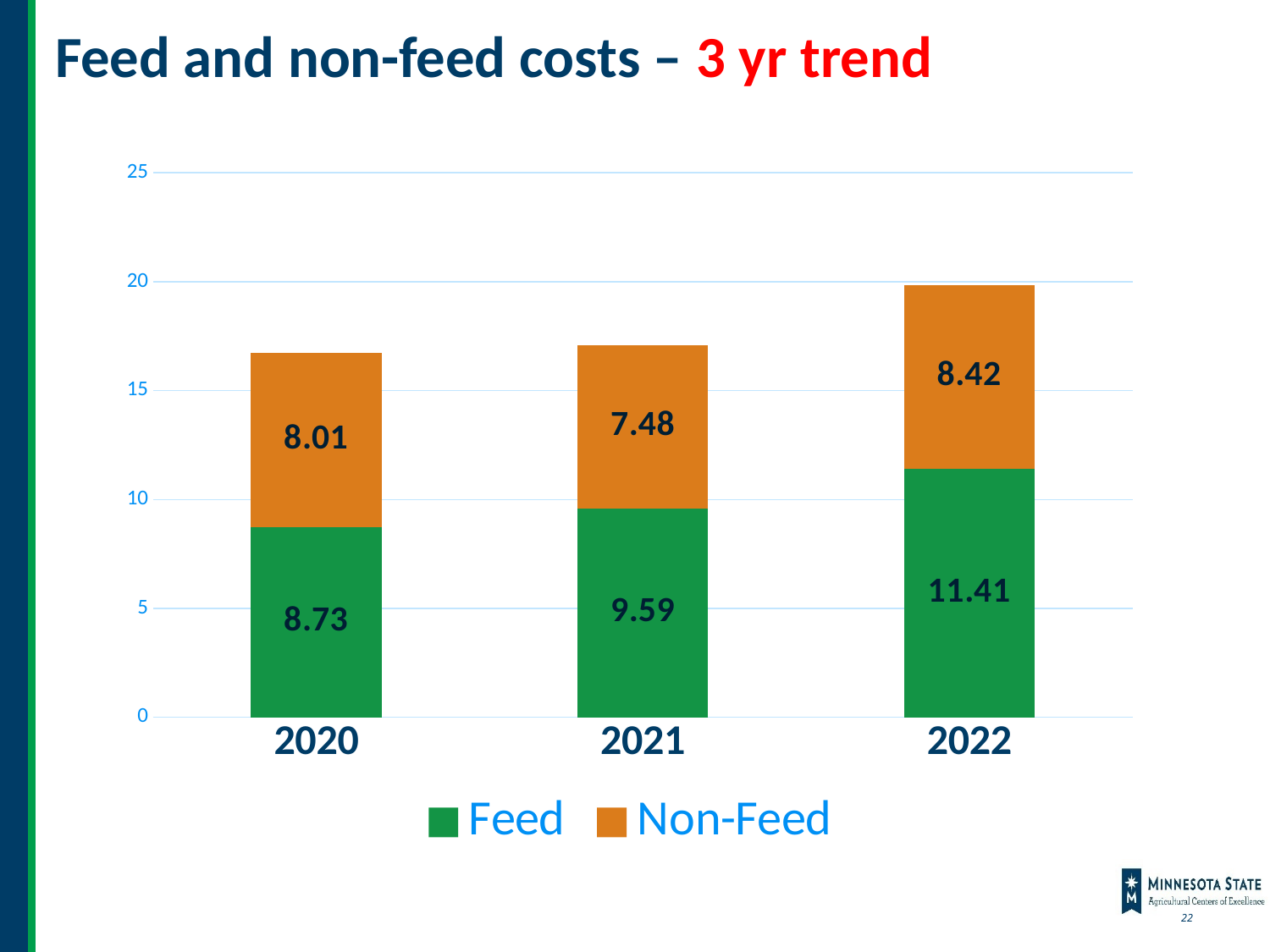
Which year has the lowest Non-Feed cost? 2021 Which is larger in 2020, the Feed cost or the Non-Feed cost? Feed What is the total of the stacked bar for 2020? 16.74 What is the Non-Feed cost for 2021? 7.48 How many years are shown on the x axis? 3 Which year has the highest Feed cost? 2022 What is the difference between the Feed cost in 2022 and the Feed cost in 2020? 2.68 How many series does the legend list? 2 What is the Non-Feed cost for 2022? 8.42 What is the total of the stacked bar for 2022? 19.83 Does the Feed cost rise or fall from 2020 to 2022? rise What is the Feed cost for 2020? 8.73